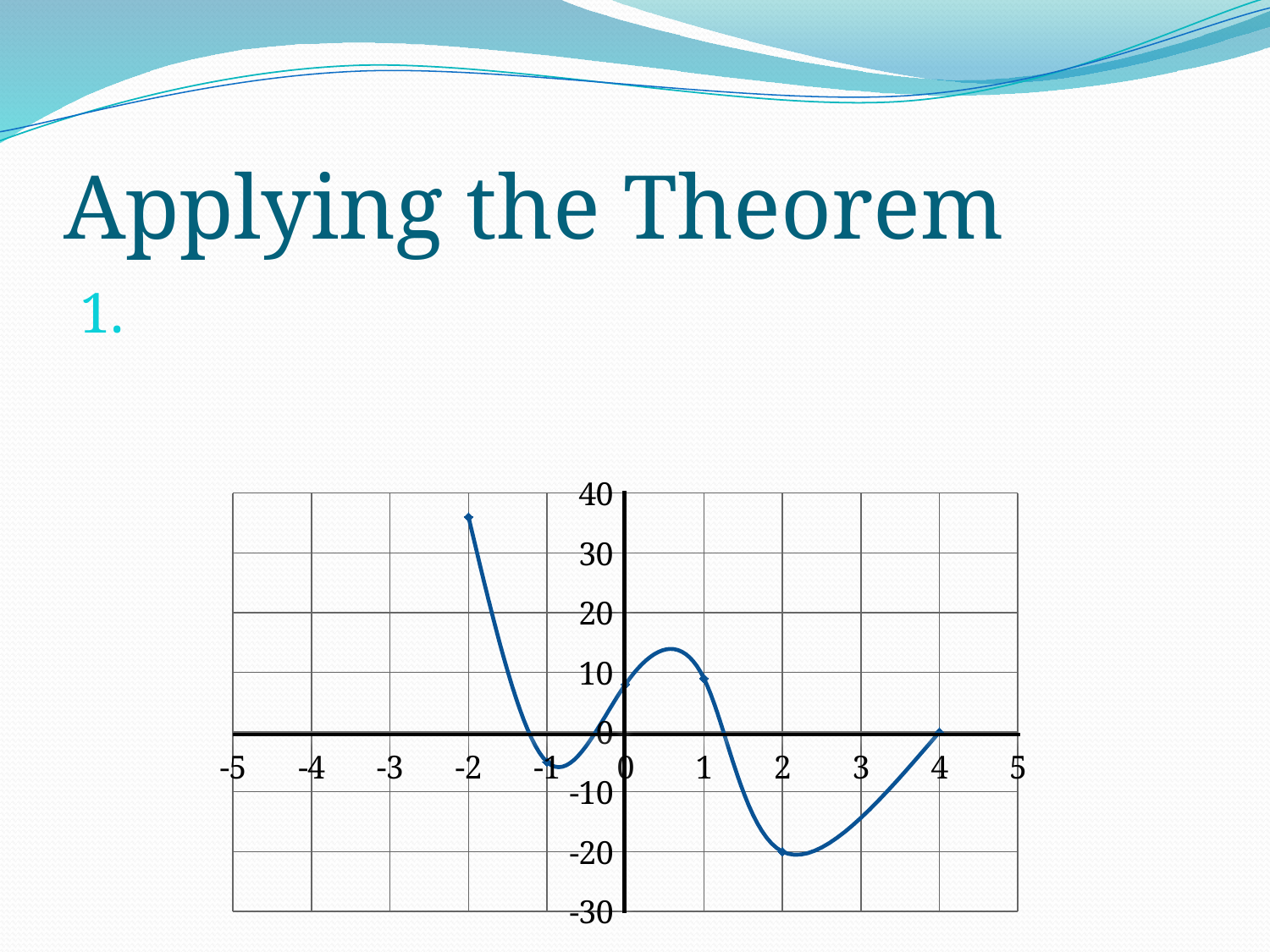
At which marked x value does the curve reach its lowest point? 2 At which marked x value does the curve reach its highest point? -2 How many marked data points are plotted on the curve? 6 Does the curve rise or fall between x = -2 and x = -1? fall Is the value of the curve at x = 2 greater or less than -10? less What kind of chart is shown on the slide? line chart Which is larger, the value of the curve at x = -2 or at x = 1? x = -2 Is the value of the curve at x = 3 greater or less than -10? less Is the value of the curve at x = -2 greater or less than 30? greater What is the value of the curve at x = 4? 0 What is the highest value labelled on the y axis? 40